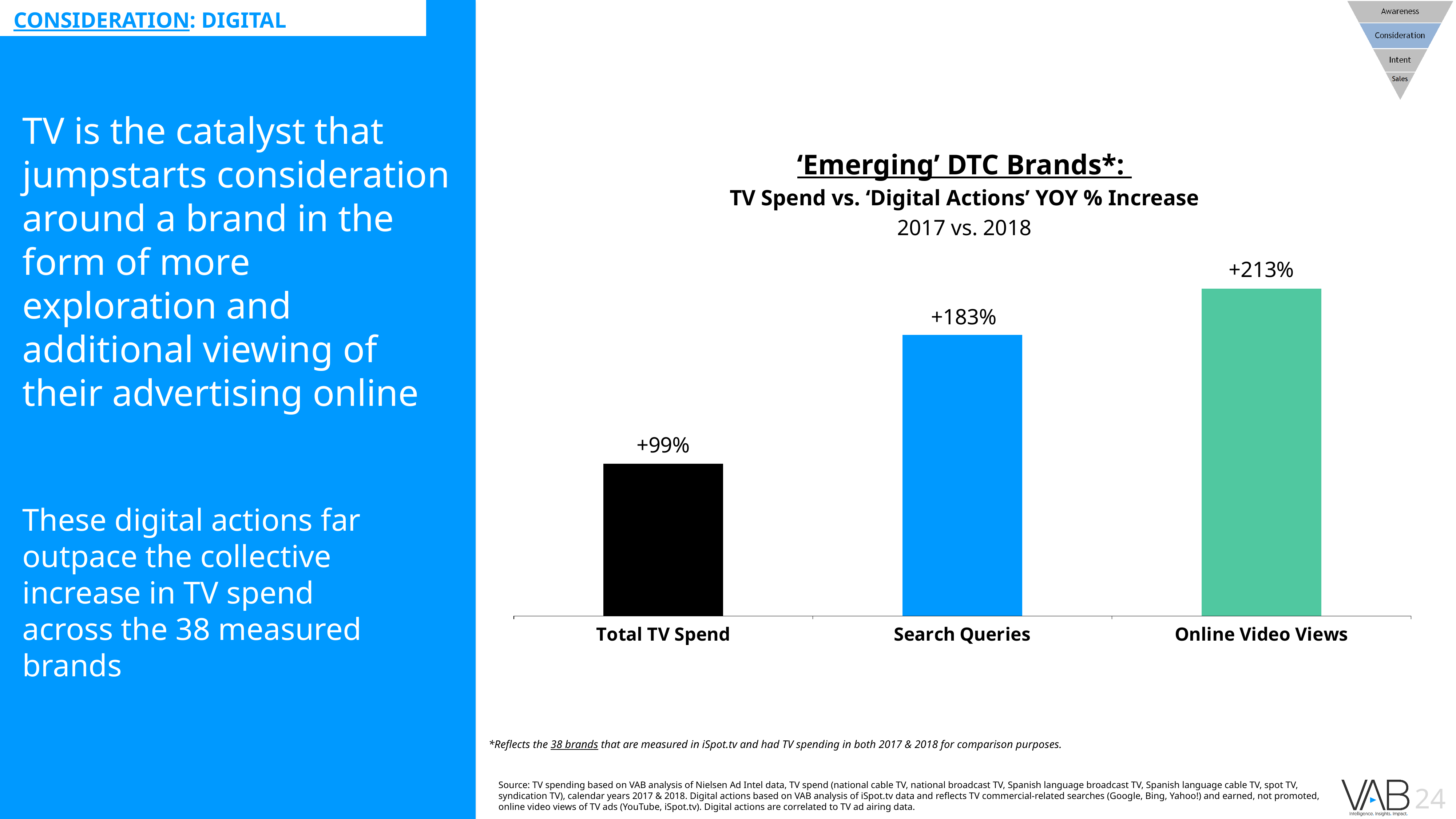
Do the values rise or fall from left to right across the categories? Rise What is the YOY % increase shown for Total TV Spend? +99% Which is larger, the YOY % increase for Search Queries or for Online Video Views? Online Video Views What is the YOY % increase shown for Search Queries? +183% What is the difference between the YOY % increase for Search Queries and Total TV Spend? 84 percentage points What is the difference between the YOY % increase for Online Video Views and Total TV Spend? 114 percentage points What is the YOY % increase shown for Online Video Views? +213% Which category has the highest YOY % increase? Online Video Views What kind of chart is shown on the slide? Bar chart Which category has the lowest YOY % increase? Total TV Spend How many categories are shown in the chart? 3 Which two years does the chart compare? 2017 vs. 2018